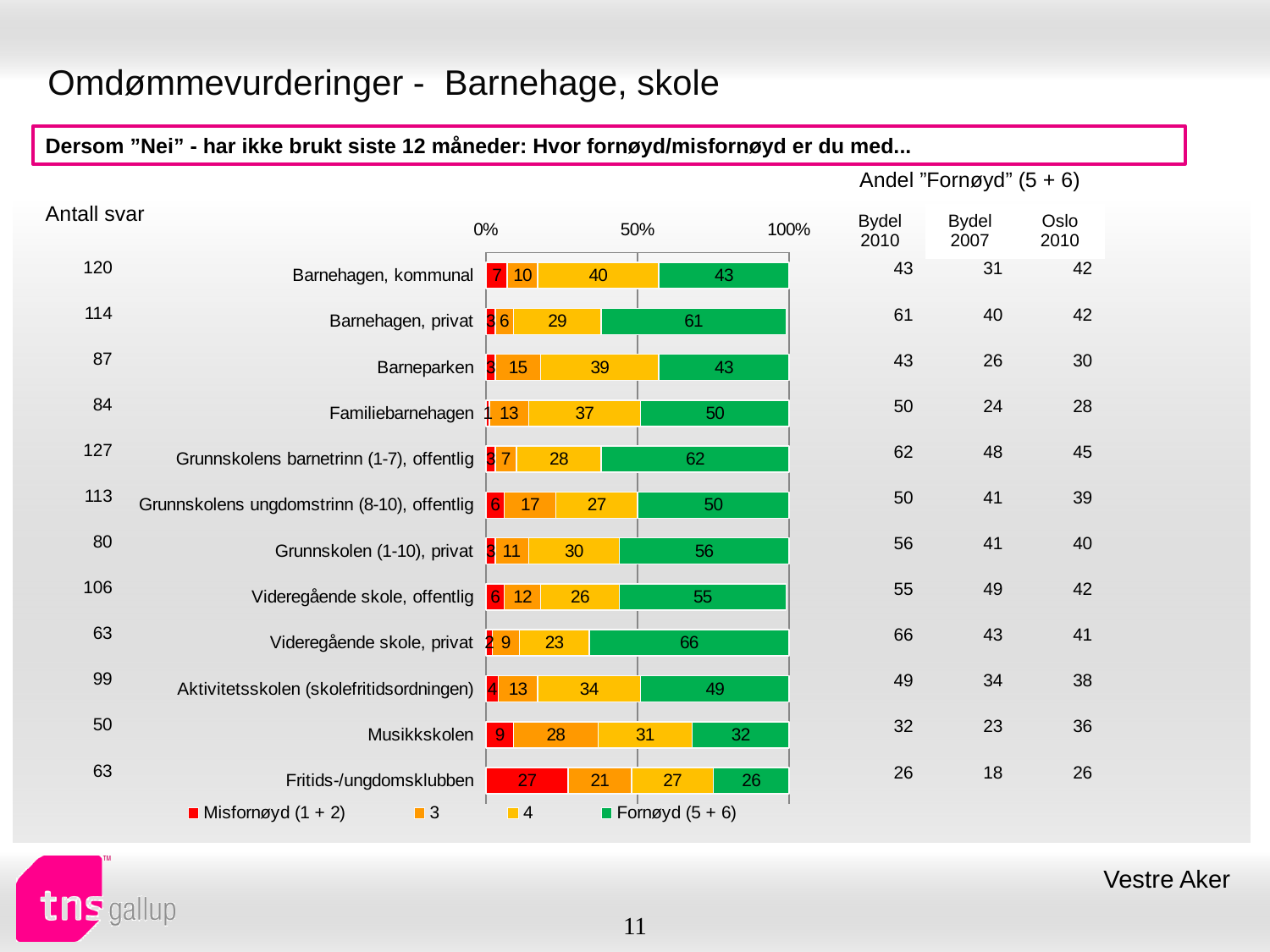
How much larger is the Fornøyd (5 + 6) value for Barnehagen, privat than for Barnehagen, kommunal? 18 What is the value of the Fornøyd (5 + 6) segment for Barnehagen, privat? 61 What kind of chart is shown on the slide? Stacked bar chart How many series does the legend list? 4 What is the value of the '4' segment for Barneparken? 39 Which series is shown in green in the legend? Fornøyd (5 + 6) Which has the larger Fornøyd (5 + 6) value: Musikkskolen or Aktivitetsskolen (skolefritidsordningen)? Aktivitetsskolen (skolefritidsordningen) Which category has the highest Fornøyd (5 + 6) value? Videregående skole, privat Which category has the lowest Fornøyd (5 + 6) value? Fritids-/ungdomsklubben What is the value of the '3' segment for Musikkskolen? 28 What is the value of the Misfornøyd (1 + 2) segment for Fritids-/ungdomsklubben? 27 How many categories are shown in the chart? 12